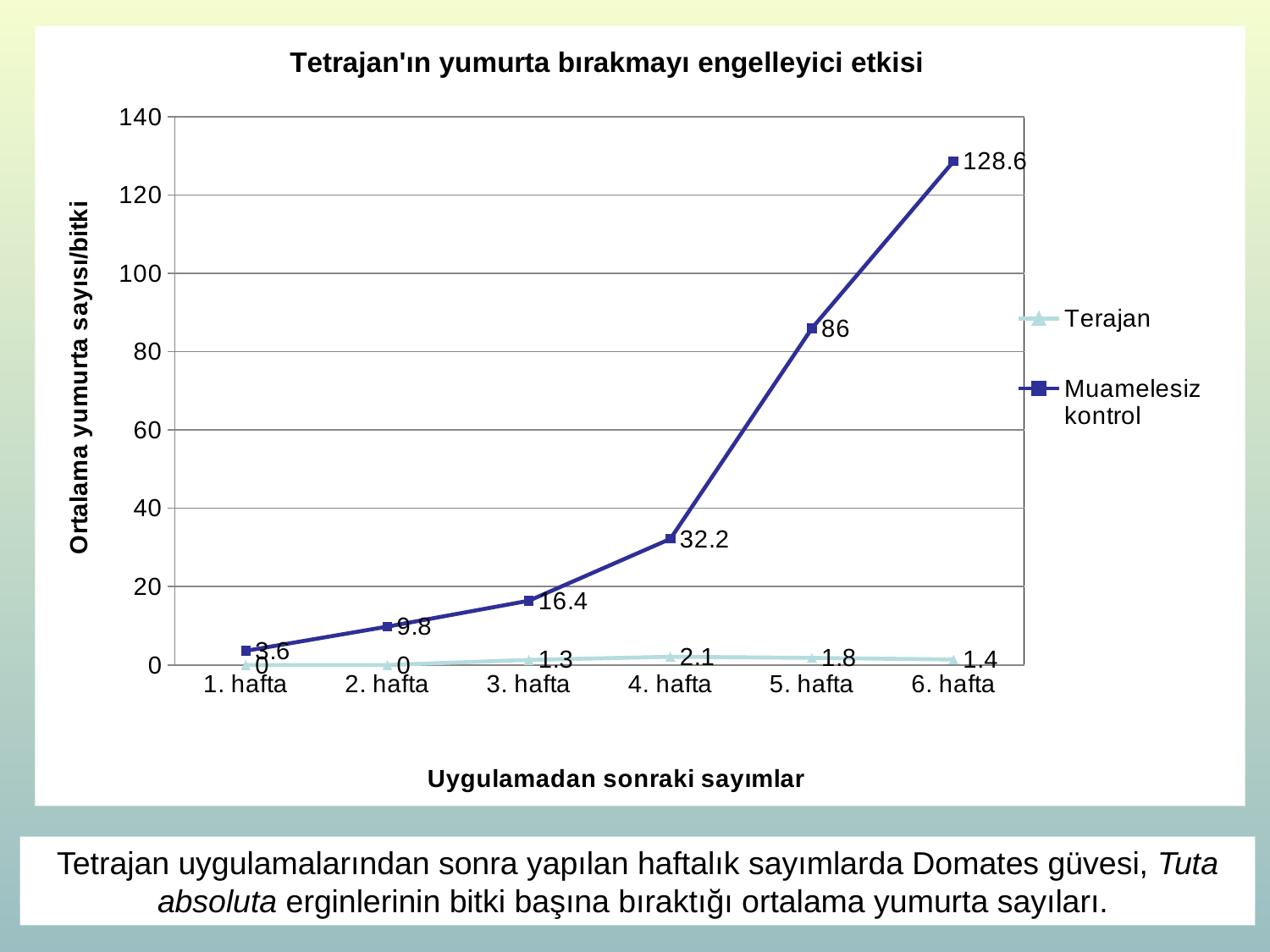
What is the value for Terajan at 6. hafta? 1.4 What is the value for Terajan at 4. hafta? 2.1 What is the difference between Muamelesiz kontrol at 6. hafta and at 5. hafta? 42.6 At which week does Terajan reach its highest value? 4. hafta What is the value for Muamelesiz kontrol at 6. hafta? 128.6 What type of chart is shown on the slide? line chart At which week does Muamelesiz kontrol reach its highest value? 6. hafta What is the value for Muamelesiz kontrol at 4. hafta? 32.2 How many weeks (categories) are shown on the x axis? 6 Which series has the larger value at 5. hafta, Terajan or Muamelesiz kontrol? Muamelesiz kontrol How many series does the legend list? 2 Does the Muamelesiz kontrol series rise or fall from 1. hafta to 6. hafta? rise